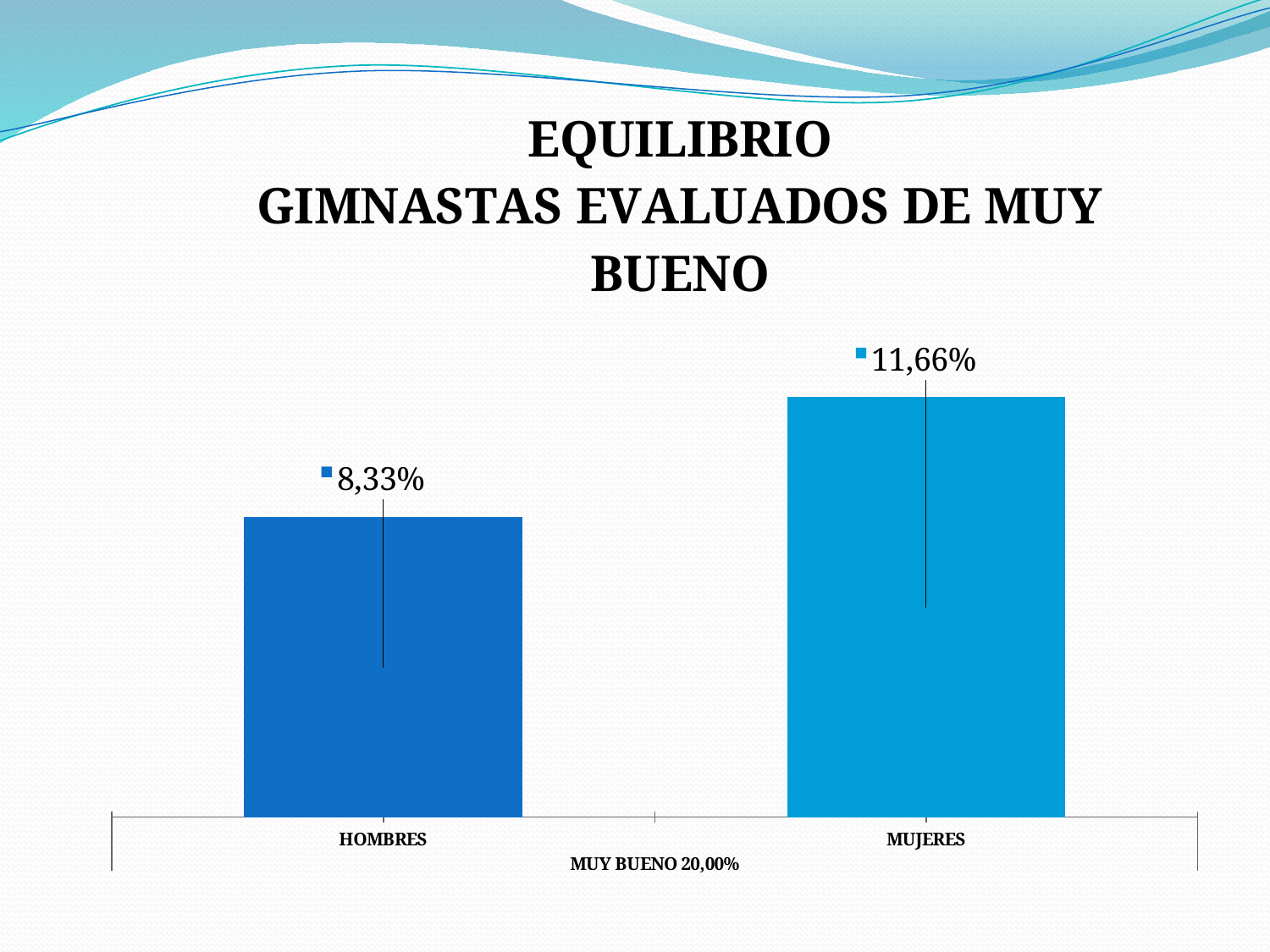
Do the values rise or fall from HOMBRES to MUJERES? Rise What kind of chart is shown on the slide? Bar chart Which category has the lowest value? HOMBRES What is the label printed below the category axis? MUY BUENO 20,00% Which category has the highest value? MUJERES What is the title of the chart? EQUILIBRIO GIMNASTAS EVALUADOS DE MUY BUENO What is the value for MUJERES? 11,66% What is the value for HOMBRES? 8,33% What is the difference between the values for MUJERES and HOMBRES? 3,33% Which is larger, the value for HOMBRES or the value for MUJERES? MUJERES How many categories are shown on the x axis? 2